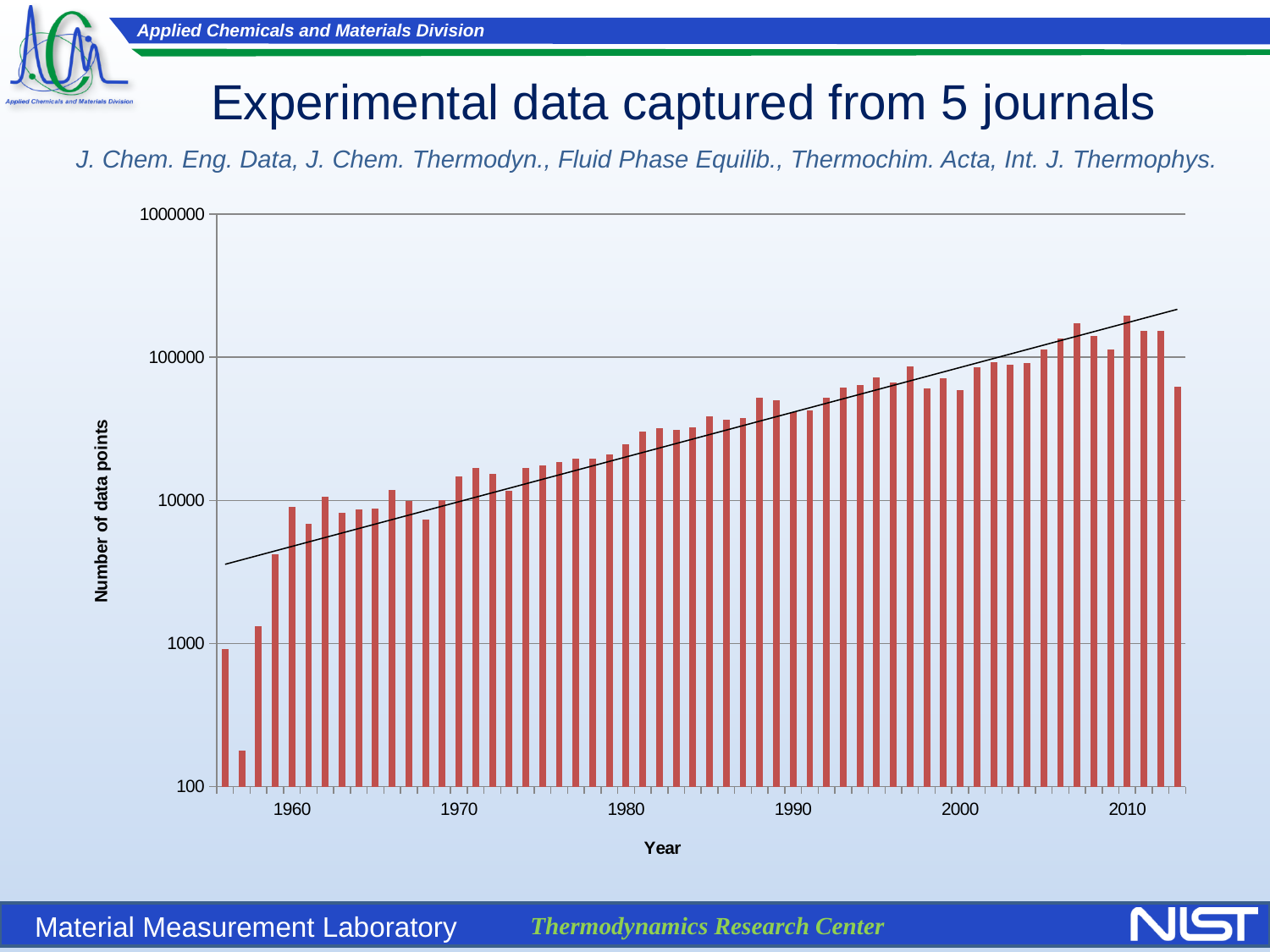
What kind of chart is shown on the slide? bar chart Is the value for 2010 greater or less than 100000? greater What is the label of the vertical axis? Number of data points Do the number of data points generally rise or fall from 1960 to 2010? rise Is the value for 1960 greater or less than 10000? less Is the value for 1970 greater or less than 10000? greater Which year has more data points, 1960 or 1980? 1980 What is the title of the chart on the slide? Experimental data captured from 5 journals Which year has more data points, 2000 or 2010? 2010 Which year has the lowest number of data points? 1957